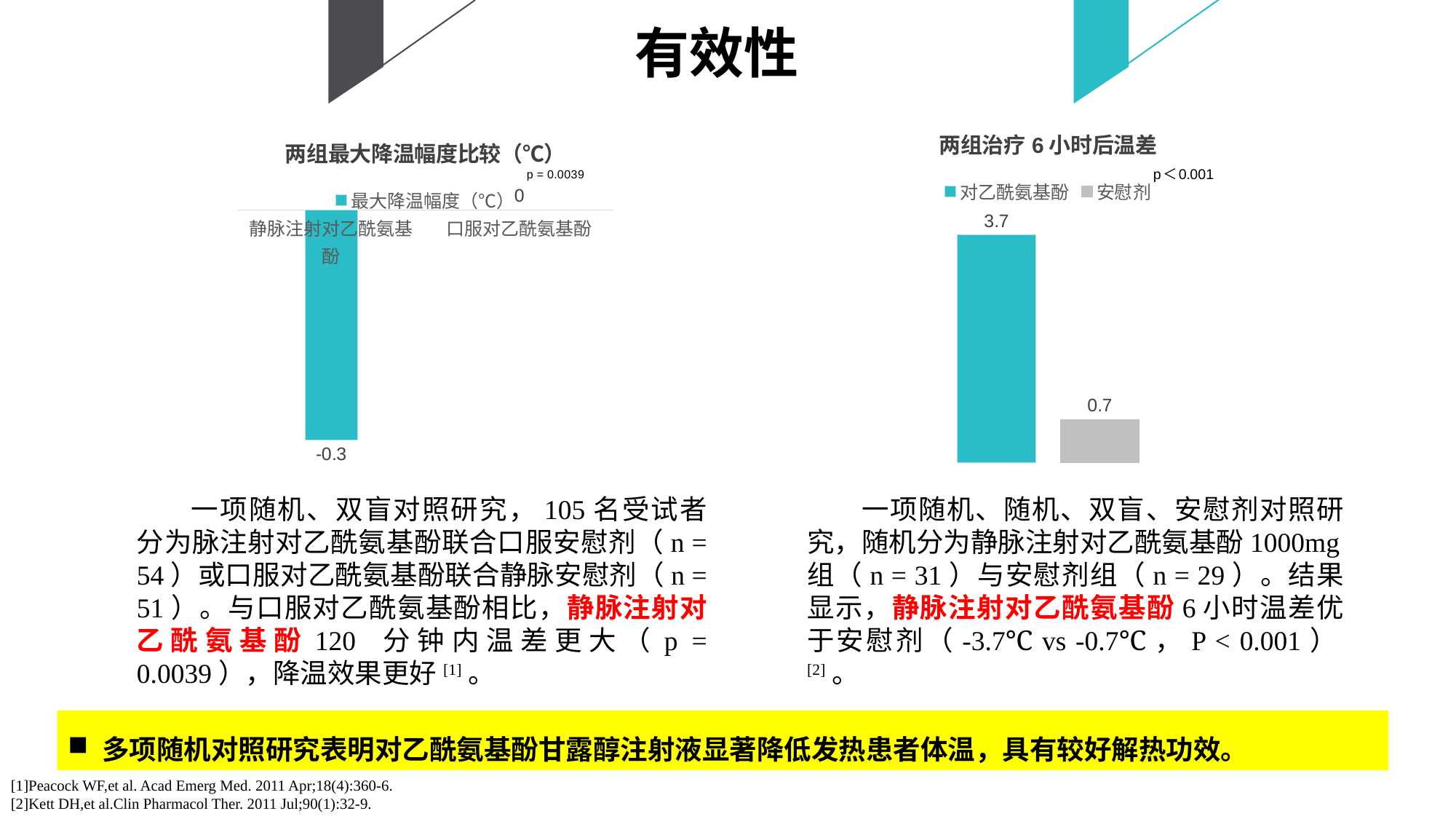
What kind of chart is the chart titled 两组治疗 6 小时后温差? bar chart In the chart titled 两组最大降温幅度比较（℃）, what is the value for 静脉注射对乙酰氨基酚? -0.3 In the chart titled 两组最大降温幅度比较（℃）, what p value is printed on the chart? p = 0.0039 In the chart titled 两组最大降温幅度比较（℃）, what is the value for 口服对乙酰氨基酚? 0 In the chart titled 两组治疗 6 小时后温差, which series has the lower value? 安慰剂 In the chart titled 两组治疗 6 小时后温差, what is the value for 对乙酰氨基酚? 3.7 In the chart titled 两组治疗 6 小时后温差, which series has the higher value? 对乙酰氨基酚 In the chart titled 两组治疗 6 小时后温差, what is the difference between the 对乙酰氨基酚 value and the 安慰剂 value? 3.0 In the chart titled 两组最大降温幅度比较（℃）, what is the legend entry? 最大降温幅度（℃） In the chart titled 两组治疗 6 小时后温差, how many series does the legend list? 2 In the chart titled 两组治疗 6 小时后温差, what is the value for 安慰剂? 0.7 In the chart titled 两组最大降温幅度比较（℃）, how many categories are shown on the x axis? 2